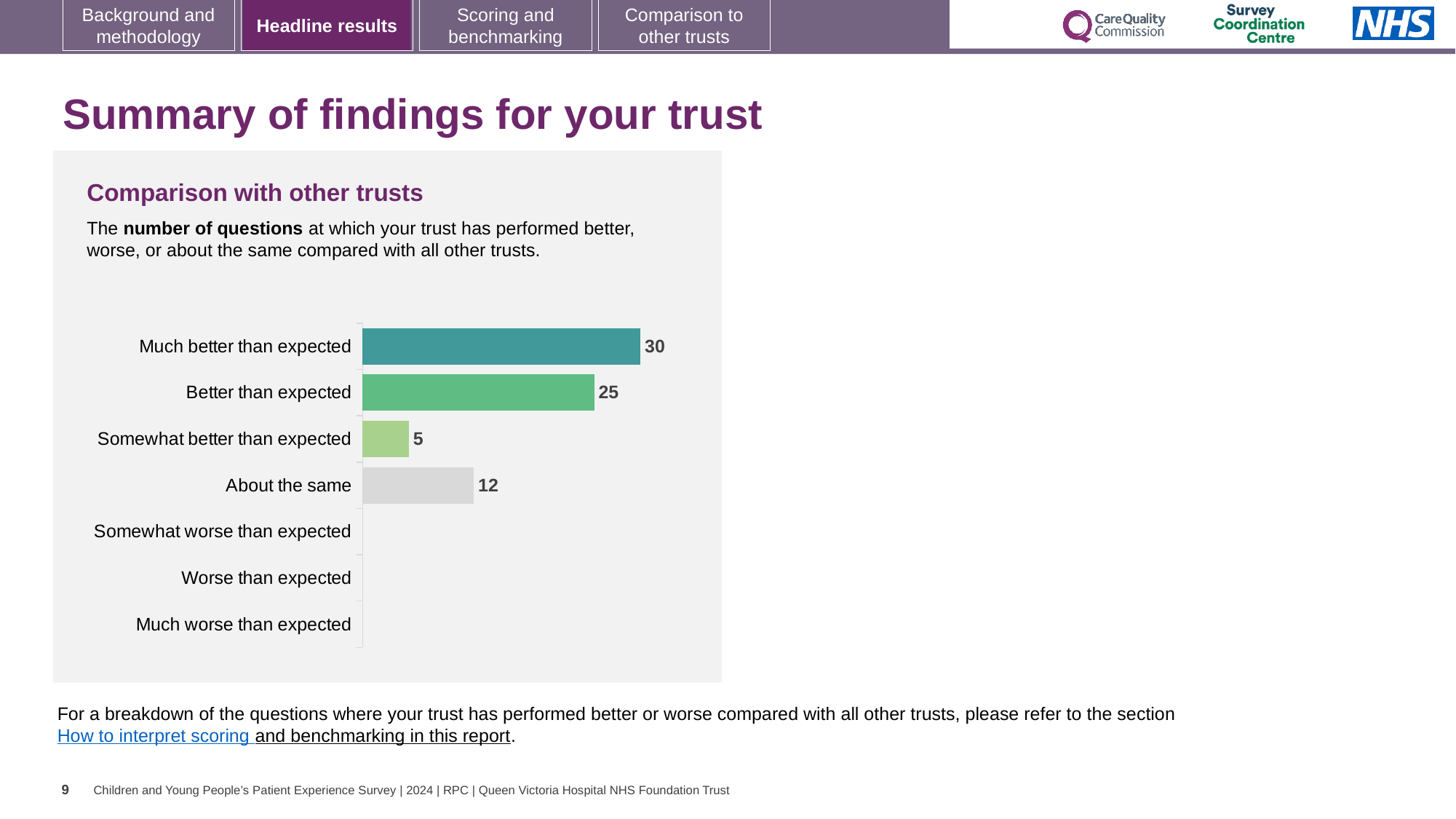
Which category has the highest value? Much better than expected What is the value for 'Better than expected'? 25 What is the value for 'Somewhat better than expected'? 5 Which is larger, 'About the same' or 'Somewhat better than expected'? About the same How many questions were rated 'About the same'? 12 What kind of chart is shown? Bar chart What is the title of the chart? Comparison with other trusts How many questions were rated 'Much better than expected'? 30 What is the total of the values shown for 'Much better than expected', 'Better than expected', 'Somewhat better than expected' and 'About the same'? 72 What is the difference between 'Much better than expected' and 'Better than expected'? 5 How many categories are listed on the chart? 7 What is the difference between 'About the same' and 'Somewhat better than expected'? 7